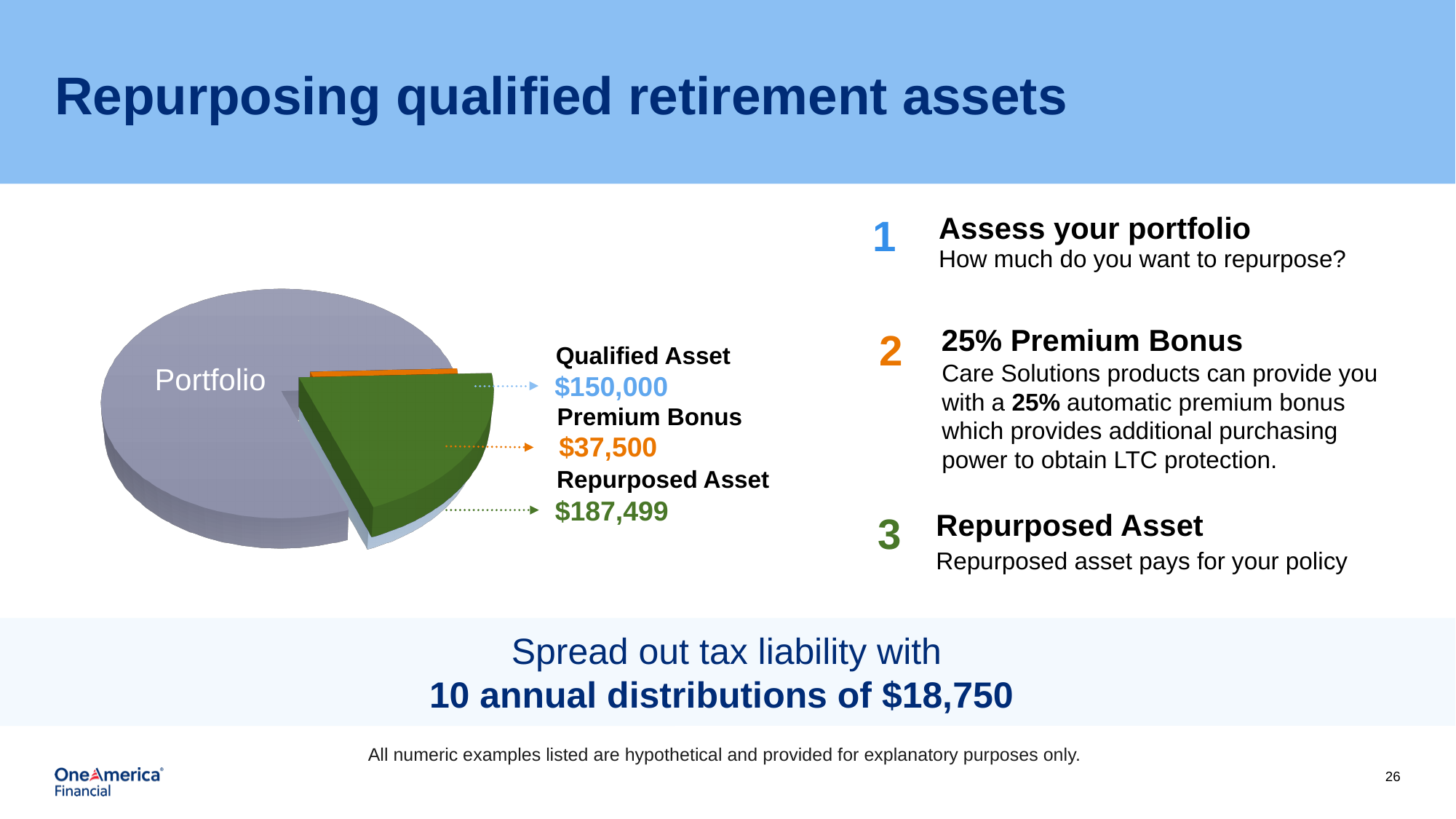
What is the value shown for the Repurposed Asset? $187,499 What is the value shown for the Premium Bonus? $37,500 Which of the three labelled values on the chart is the largest? Repurposed Asset What type of chart is shown on the slide? Pie chart What colour is used for the Premium Bonus layer of the exploded slice? Orange What is the value shown for the Qualified Asset? $150,000 How many labelled dollar values are shown next to the chart? 3 Which of the three labelled values on the chart is the smallest? Premium Bonus Which is larger, the Qualified Asset or the Premium Bonus? Qualified Asset What label appears on the large grey slice of the pie chart? Portfolio What is the difference between the Qualified Asset and the Premium Bonus values? $112,500